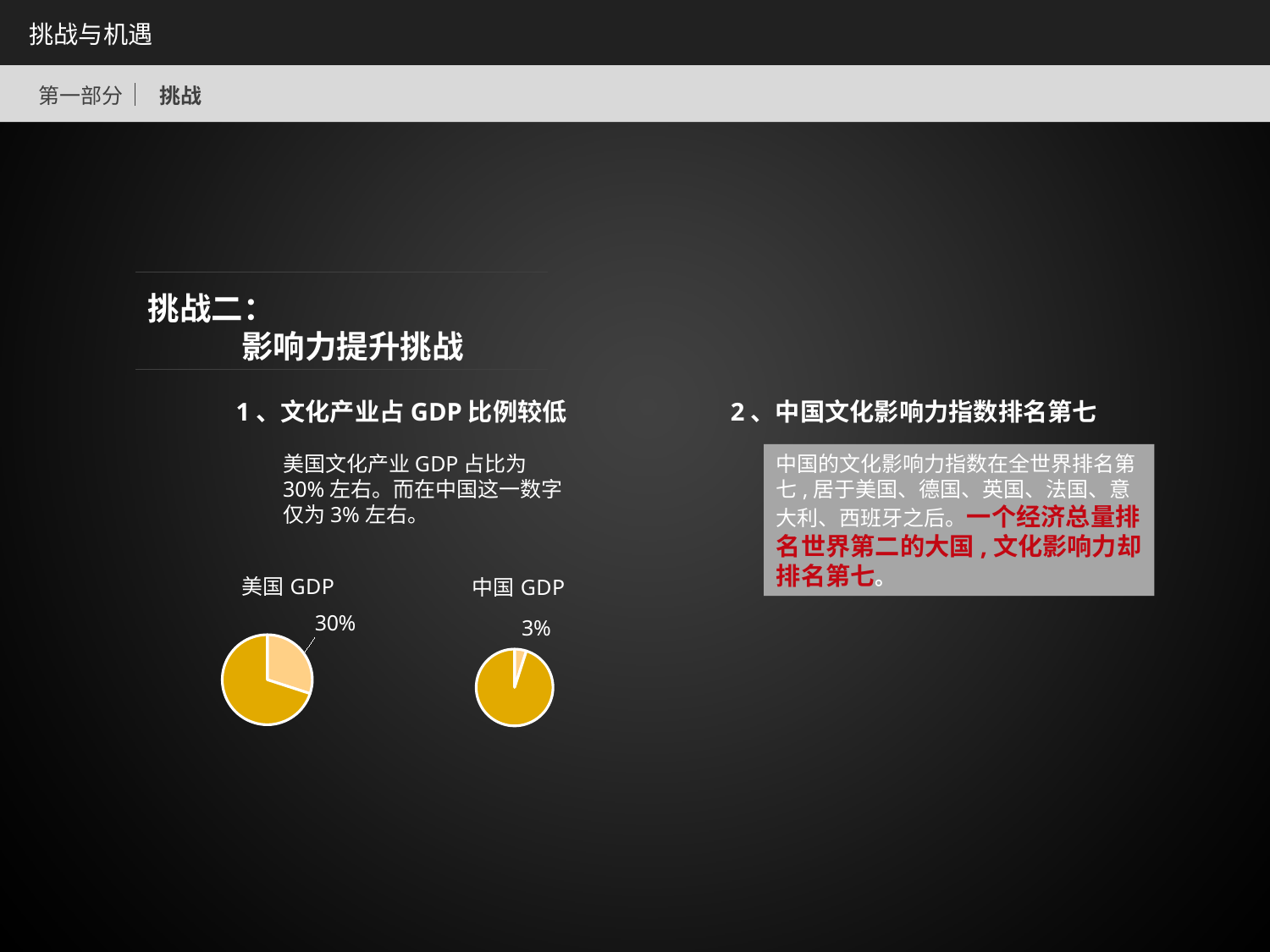
How many pie charts are shown on the slide? 2 In the 美国 GDP pie chart, is the highlighted slice greater or less than half of the pie? less Which pie chart shows the larger labelled slice, 美国 GDP or 中国 GDP? 美国 GDP In the 中国 GDP pie chart, what share of the pie does the highlighted slice represent? 3% In the pie chart titled 美国 GDP, what value is printed on the highlighted slice? 30% What is the title of the pie chart on the right? 中国 GDP What kind of chart is used for 中国 GDP? Pie chart In the 美国 GDP pie chart, what share of the pie does the lighter highlighted slice represent? 30% What kind of chart is used for 美国 GDP? Pie chart What is the title of the pie chart on the left? 美国 GDP In the pie chart titled 中国 GDP, what value is printed on the highlighted slice? 3% What is the difference between the labelled slice in the 美国 GDP pie chart and the labelled slice in the 中国 GDP pie chart? 27 percentage points